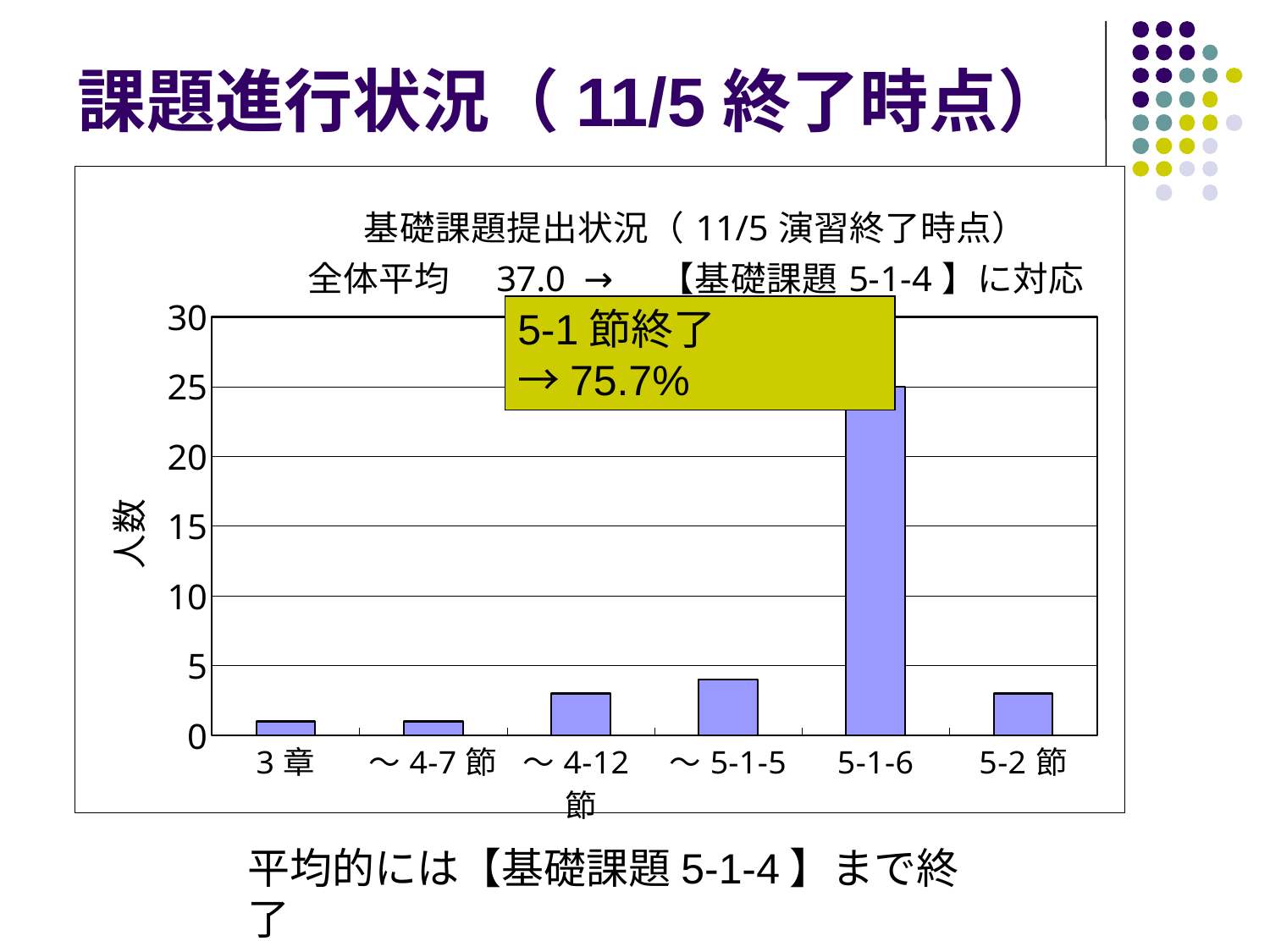
What is the label of the vertical axis of the chart? 人数 What is the value for 5-1-6 in the chart? 25 What type of chart is shown on the slide? bar chart Which is larger, the value for ～4-12節 or the value for 3章? ～4-12節 Is the value for 3章 greater or less than 5? less Which category has the highest value in the chart? 5-1-6 What is the title of the chart? 基礎課題提出状況（11/5 演習終了時点） 全体平均 37.0 → 【基礎課題 5-1-4】に対応 Is the value for ～5-1-5 greater or less than 5? less Is the value for 5-1-6 greater or less than 20? greater How many categories are shown on the x axis of the chart? 6 Which is larger, the value for 5-1-6 or the value for 5-2節? 5-1-6